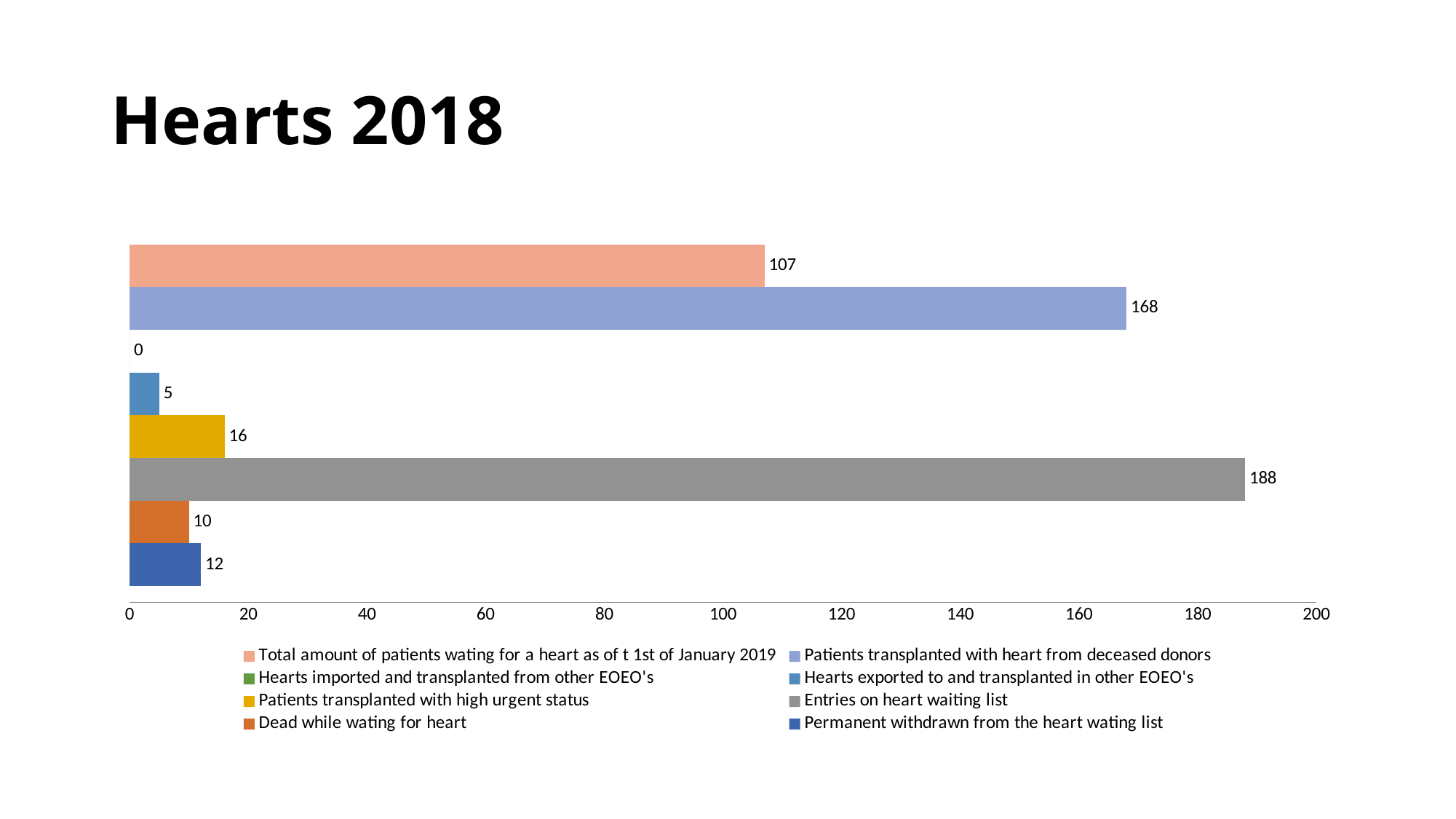
What is the value for Dead while wating for heart? 10 What kind of chart is shown on the slide? Bar chart What is the difference between Entries on heart waiting list and Patients transplanted with heart from deceased donors? 20 What is the value for Hearts imported and transplanted from other EOEO's? 0 What is the value for Patients transplanted with heart from deceased donors? 168 What is the value for Entries on heart waiting list? 188 How many series does the legend list? 8 Which is larger: Patients transplanted with high urgent status or Permanent withdrawn from the heart wating list? Patients transplanted with high urgent status What is the value for Total amount of patients wating for a heart as of t 1st of January 2019? 107 What is the title of the slide? Hearts 2018 Which series has the highest value? Entries on heart waiting list Which series has the lowest value? Hearts imported and transplanted from other EOEO's